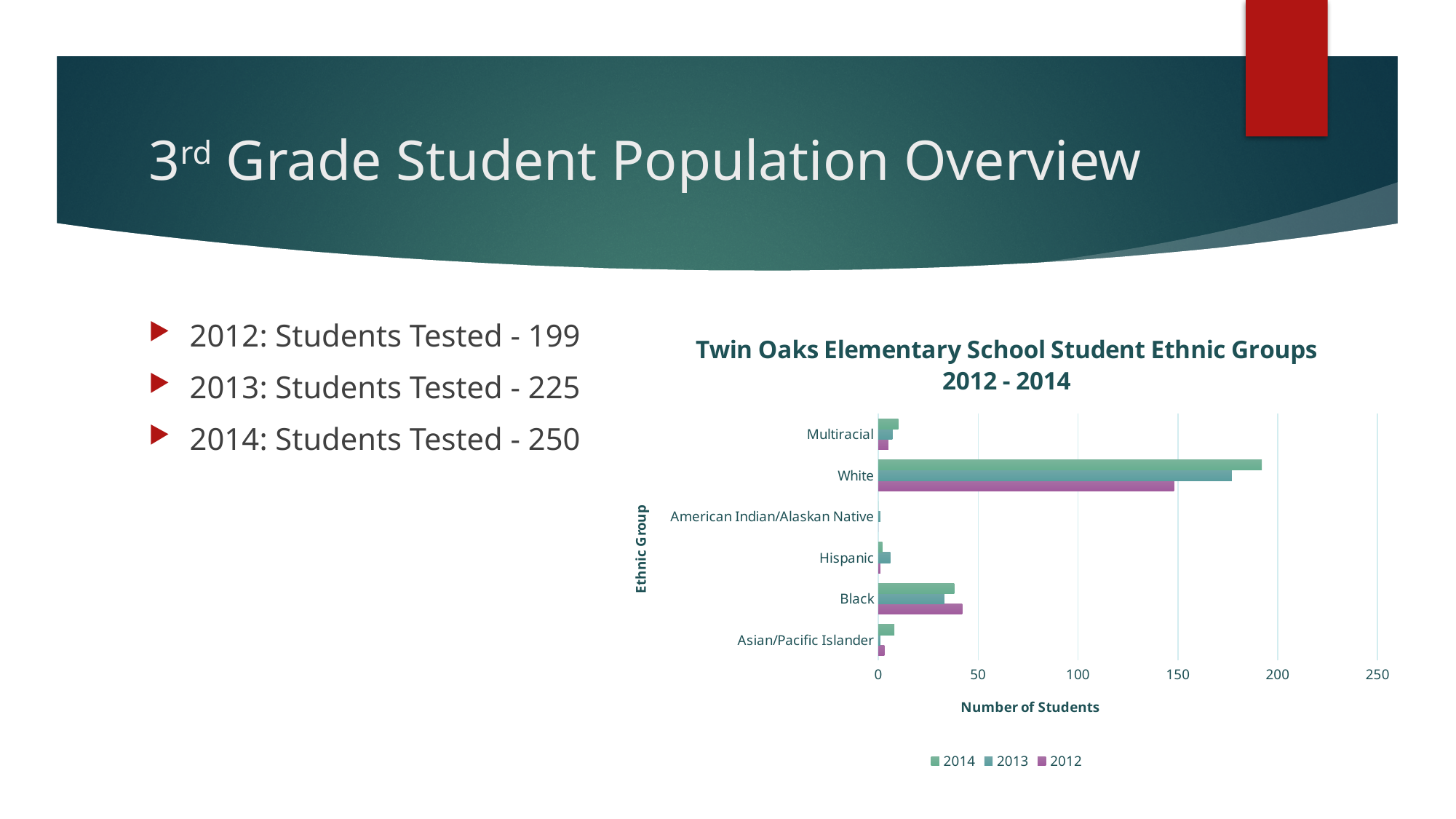
What kind of chart is shown on the slide? Bar chart What is the label of the horizontal axis of the chart? Number of Students Is the 2014 value for White greater or less than 150? greater Is the 2012 value for White greater or less than 100? greater Which ethnic group has the lowest number of students in the chart? American Indian/Alaskan Native Is the 2012 value for Black greater or less than 50? less How many series does the chart legend list? 3 For the White group, which year has the larger value, 2014 or 2013? 2014 For the Black group, which year has the larger value, 2012 or 2013? 2012 What is the title of the chart? Twin Oaks Elementary School Student Ethnic Groups 2012 - 2014 How many ethnic group categories are shown on the chart? 6 Which ethnic group has the highest number of students in the chart? White